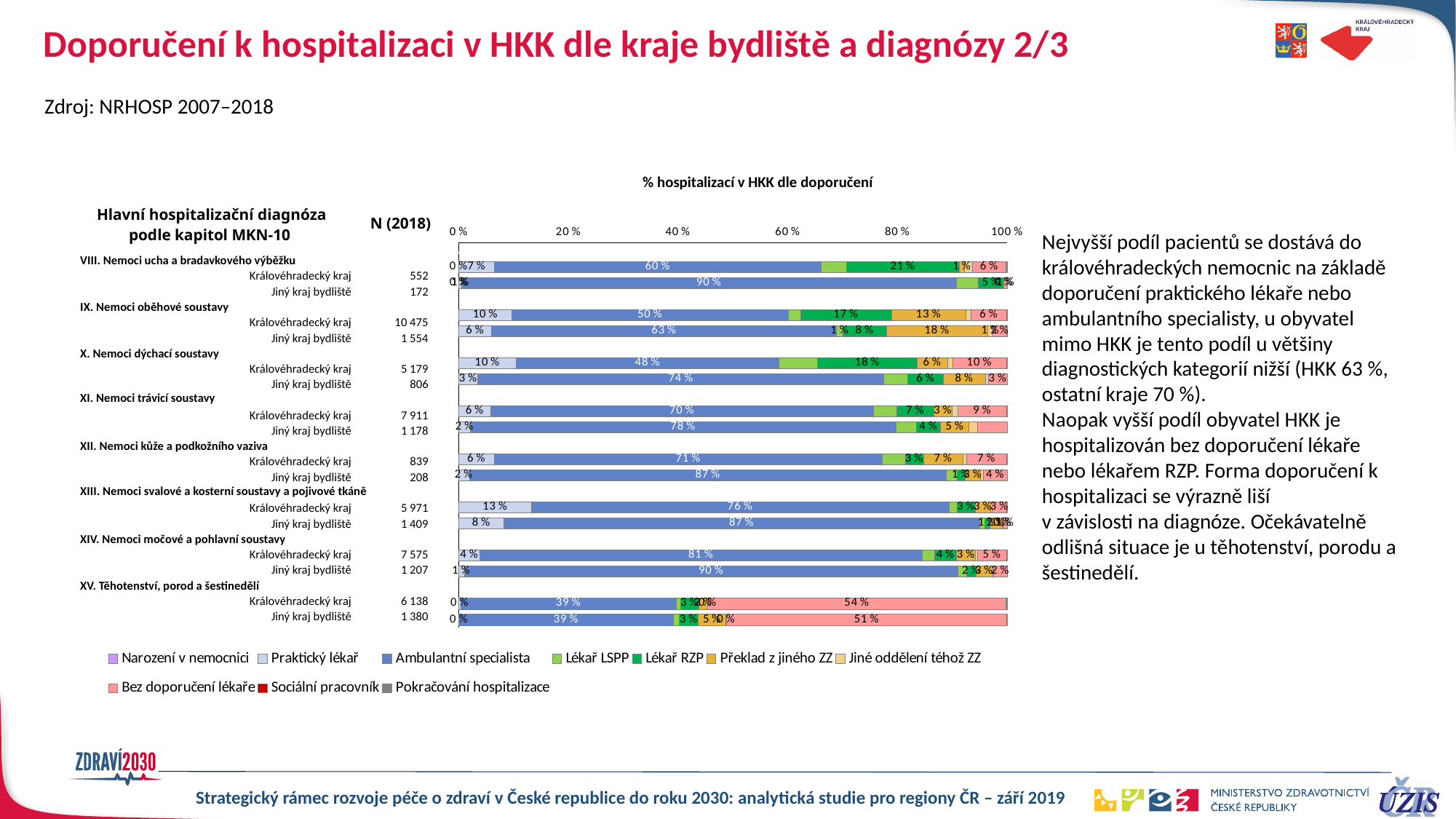
How many bars (diagnosis-region rows) are plotted in the chart? 16 What is the difference between the Ambulantní specialista share for XIV. Nemoci močové a pohlavní soustavy, Jiný kraj bydliště (90 %) and Královéhradecký kraj (81 %)? 9 % For X. Nemoci dýchací soustavy, which has the larger Ambulantní specialista share: Královéhradecký kraj or Jiný kraj bydliště? Jiný kraj bydliště What kind of chart is shown on the slide? Stacked bar chart What share of hospitalizations for XIII. Nemoci svalové a kosterní soustavy a pojivové tkáně, Jiný kraj bydliště, was recommended by Ambulantní specialista? 87 % What share of hospitalizations for IX. Nemoci oběhové soustavy, Královéhradecký kraj, was recommended by Ambulantní specialista? 50 % Which bar has the highest share for Bez doporučení lékaře? XV. Těhotenství, porod a šestinedělí, Královéhradecký kraj What is the N (2018) value for IX. Nemoci oběhové soustavy, Královéhradecký kraj? 10 475 What is the title of the chart? % hospitalizací v HKK dle doporučení What share of hospitalizations for XV. Těhotenství, porod a šestinedělí, Královéhradecký kraj, was Bez doporučení lékaře? 54 % What share of hospitalizations for VIII. Nemoci ucha a bradavkového výběžku, Královéhradecký kraj, was recommended by Lékař RZP? 21 % How many series does the chart legend list? 10